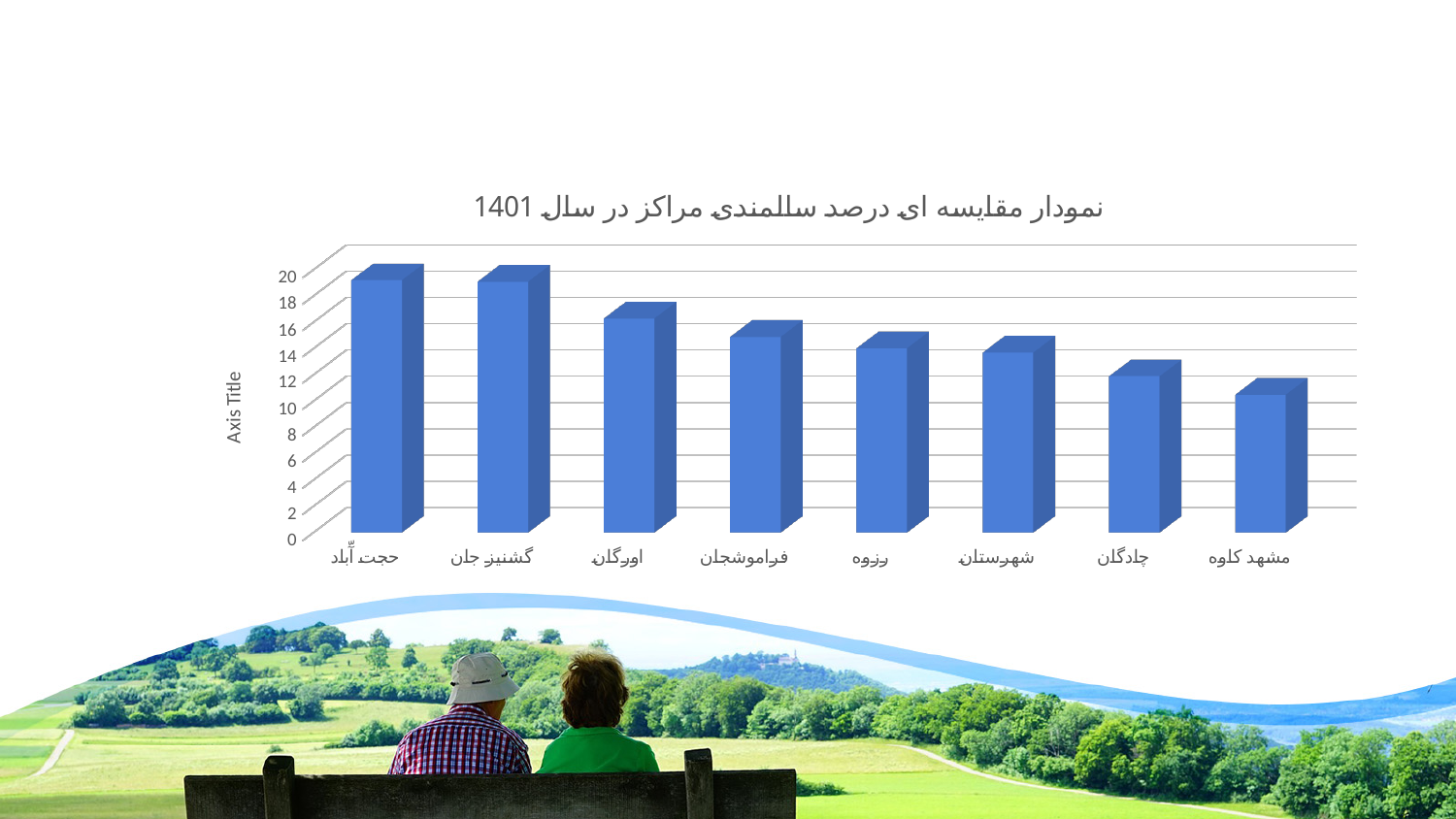
How many categories are plotted on the chart? 8 Which category has the lowest value on the chart? مشهد کاوه Which has the larger value, اورگان or چادگان? اورگان Is the value for حجت آباد greater or less than 18? greater Is the value for اورگان greater or less than 14? greater Which has the larger value, فراموشجان or مشهد کاوه? فراموشجان Is the value for چادگان greater or less than 14? less What is the title of the chart? نمودار مقایسه ای درصد سالمندی مراکز در سال 1401 What kind of chart is shown on the slide? bar chart Do the values rise or fall moving from left to right along the x axis? fall